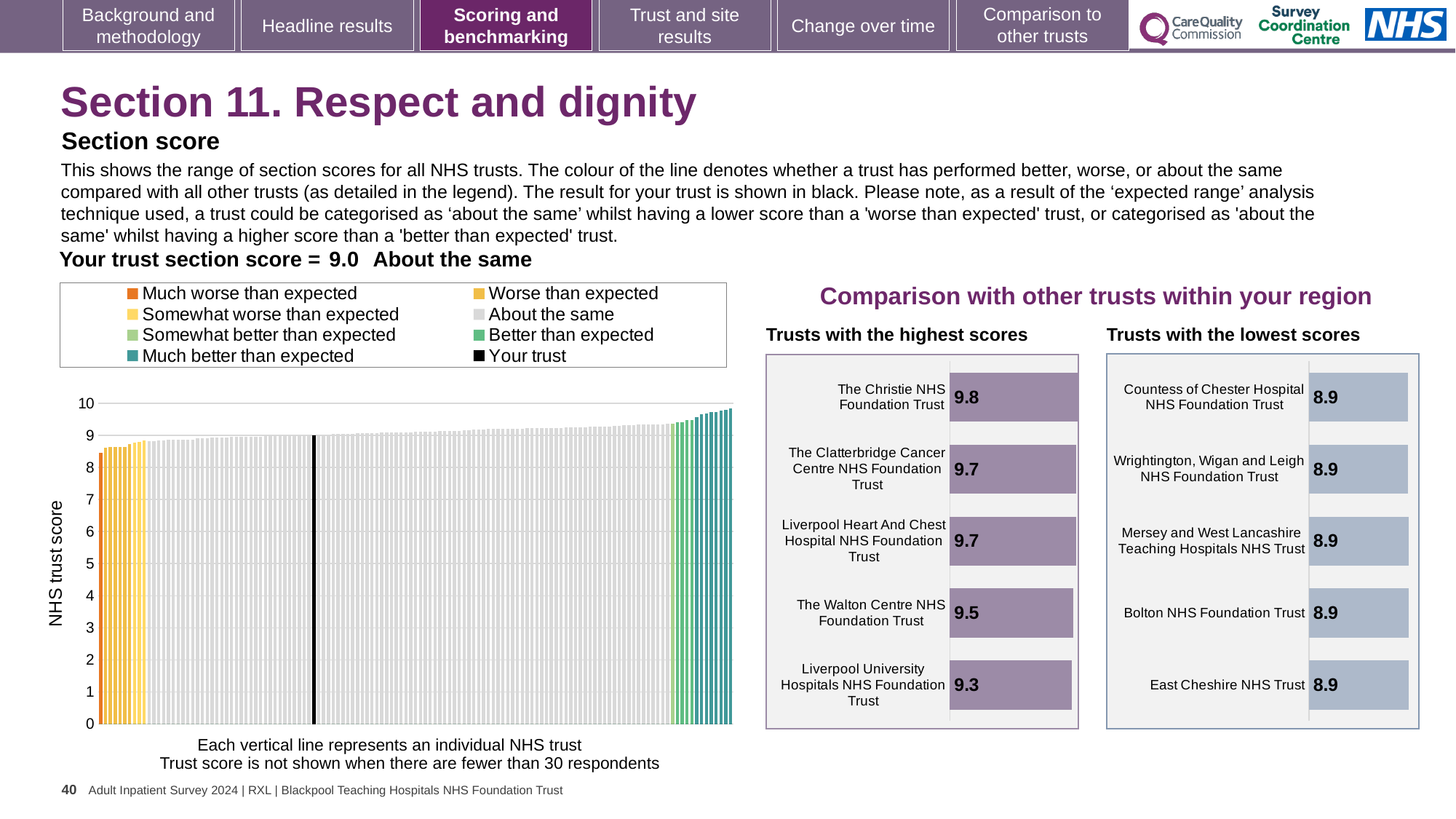
What kind of chart is the large chart on the left showing NHS trust scores? bar chart In the large chart on the left, what is the label on the vertical axis? NHS trust score In the 'Trusts with the highest scores' chart, which has the larger score: The Walton Centre NHS Foundation Trust or Liverpool University Hospitals NHS Foundation Trust? The Walton Centre NHS Foundation Trust In the 'Trusts with the highest scores' chart, what is the difference between the scores of The Christie NHS Foundation Trust and Liverpool University Hospitals NHS Foundation Trust? 0.5 In the 'Trusts with the highest scores' chart, which trust has the highest score? The Christie NHS Foundation Trust In the large chart on the left, do the trust scores rise or fall from left to right along the x axis? rise In the 'Trusts with the lowest scores' chart, how many trusts are shown? 5 In the large chart on the left, is the value for your trust (the black bar) greater or less than 8? greater In the 'Trusts with the highest scores' chart, which trust has the lowest score? Liverpool University Hospitals NHS Foundation Trust In the large chart on the left, how many entries does the legend list? 8 In the 'Trusts with the lowest scores' chart, what is the score for Bolton NHS Foundation Trust? 8.9 In the 'Trusts with the highest scores' chart, what is the score for The Christie NHS Foundation Trust? 9.8